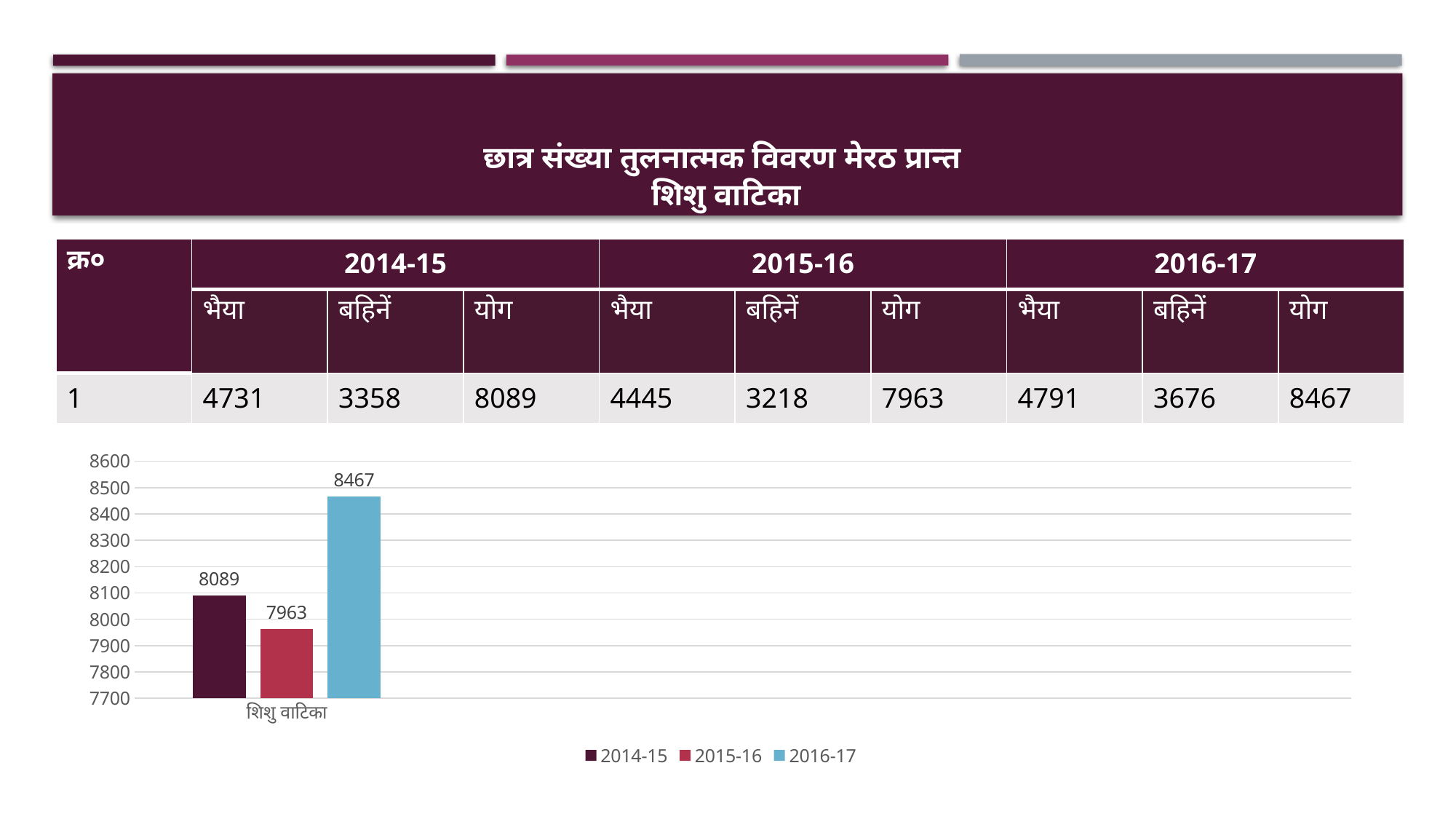
Which is larger, the value for 2014-15 or the value for 2015-16? 2014-15 How many series does the legend list? 3 What is the difference between the 2014-15 value and the 2015-16 value? 126 What is the category label shown on the x axis of the chart? शिशु वाटिका What kind of chart is shown on the slide? bar chart What is the difference between the 2016-17 value and the 2014-15 value? 378 What is the value for 2016-17 in the chart? 8467 Is the value for 2016-17 greater or less than 8400? greater Which series has the lowest value in the chart? 2015-16 Which series has the highest value in the chart? 2016-17 What is the value for 2015-16 in the chart? 7963 What is the value for 2014-15 in the chart? 8089